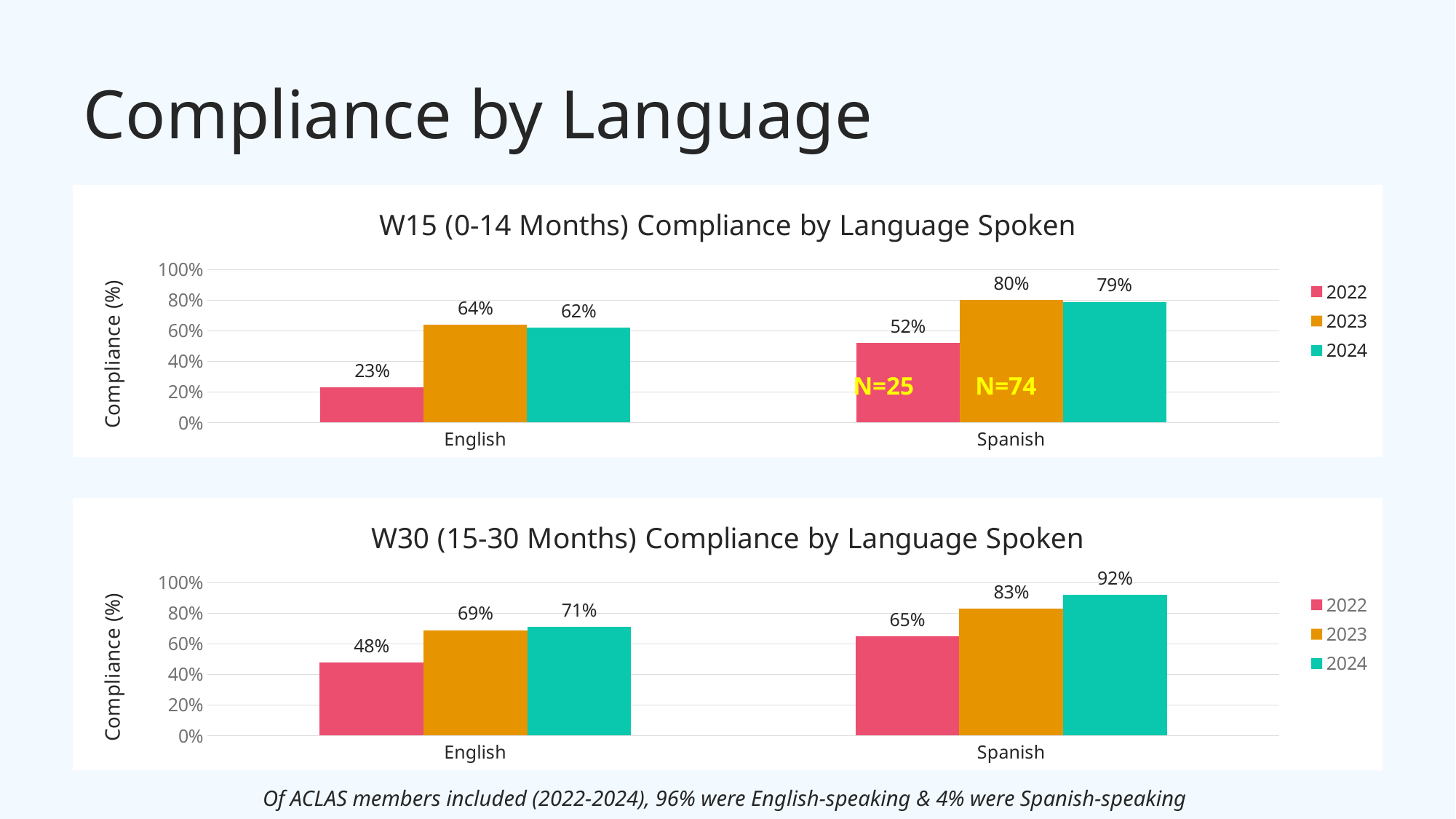
In the W30 (15-30 Months) chart, what is the 2024 compliance value for Spanish? 92% In the W30 (15-30 Months) chart, do the compliance values for Spanish rise or fall from 2022 to 2024? Rise In the W30 (15-30 Months) chart, what is the 2022 compliance value for English? 48% In the W30 (15-30 Months) chart, which is larger: the 2023 value for English or the 2023 value for Spanish? Spanish In the W15 (0-14 Months) chart, what is the difference between the 2023 and 2022 compliance values for English? 41% What kind of chart is the W30 (15-30 Months) Compliance by Language Spoken chart? Bar chart In the W15 (0-14 Months) chart, which year has the highest compliance for Spanish? 2023 In the W15 (0-14 Months) chart, what is the 2022 compliance value for English? 23% In the W30 (15-30 Months) chart, which year has the lowest compliance for English? 2022 In the W30 (15-30 Months) chart, what is the difference between the 2024 Spanish and 2024 English compliance values? 21% In the W15 (0-14 Months) chart, what is the 2023 compliance value for Spanish? 80% How many series does the legend of the W15 (0-14 Months) chart list? 3